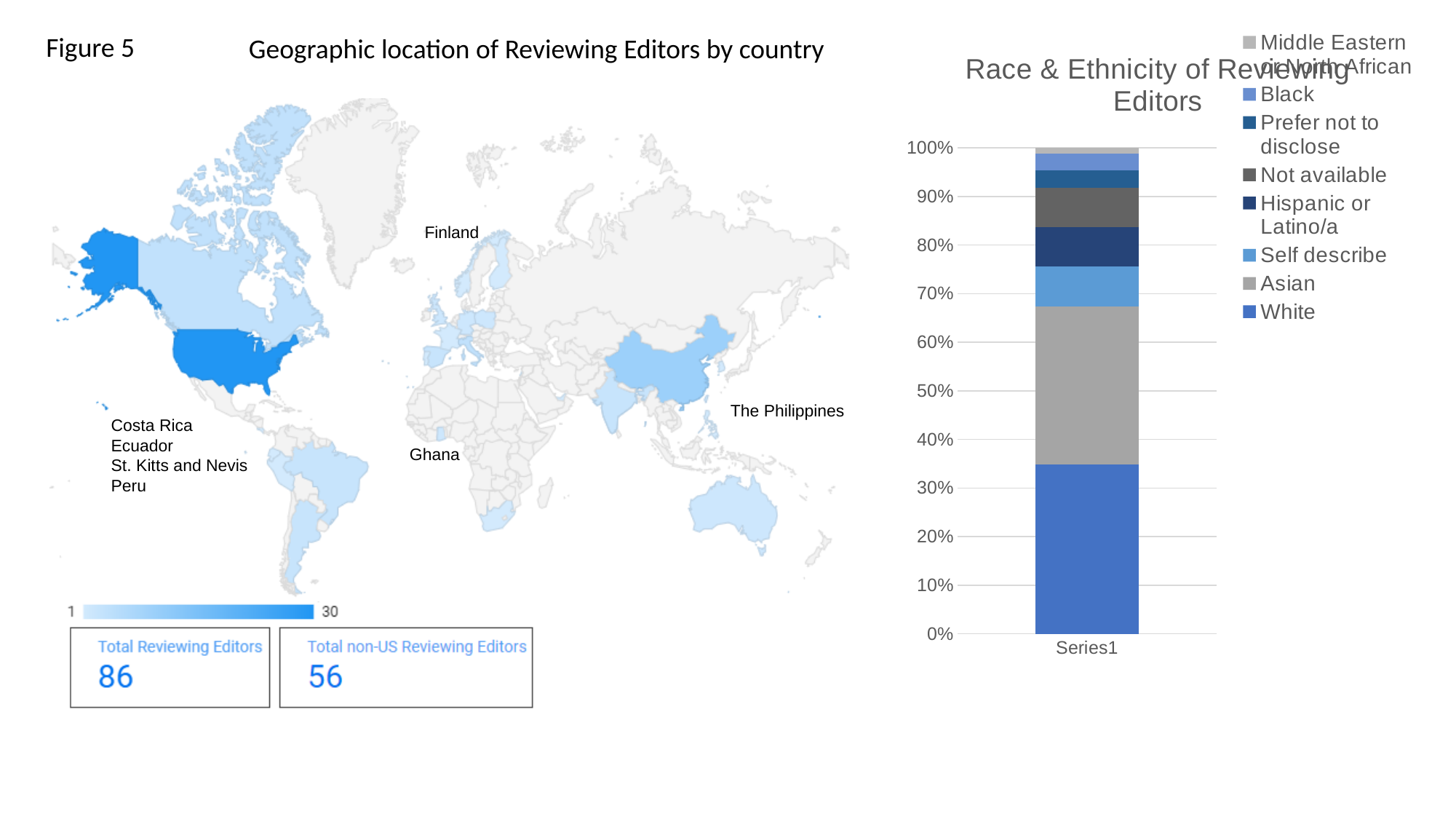
On the map chart 'Geographic location of Reviewing Editors by country', what is the Total Reviewing Editors value? 86 How many bars are plotted in the 'Race & Ethnicity of Reviewing Editors' chart? 1 How many entries does the legend of the 'Race & Ethnicity of Reviewing Editors' chart list? 8 On the map chart 'Geographic location of Reviewing Editors by country', what is the difference between Total Reviewing Editors and Total non-US Reviewing Editors? 30 In the 'Race & Ethnicity of Reviewing Editors' chart, which segment is larger: Not available or Middle Eastern or North African? Not available In the 'Race & Ethnicity of Reviewing Editors' chart, what is the category label shown under the bar? Series1 In the 'Race & Ethnicity of Reviewing Editors' chart, is the Black segment greater or less than 10%? less In the 'Race & Ethnicity of Reviewing Editors' chart, is the White segment greater or less than 30%? greater In the 'Race & Ethnicity of Reviewing Editors' chart, which segment is larger: White or Black? White In the 'Race & Ethnicity of Reviewing Editors' chart, which legend category has the smallest segment? Middle Eastern or North African On the map chart 'Geographic location of Reviewing Editors by country', what is the Total non-US Reviewing Editors value? 56 What kind of chart is the 'Race & Ethnicity of Reviewing Editors' chart? Stacked bar chart